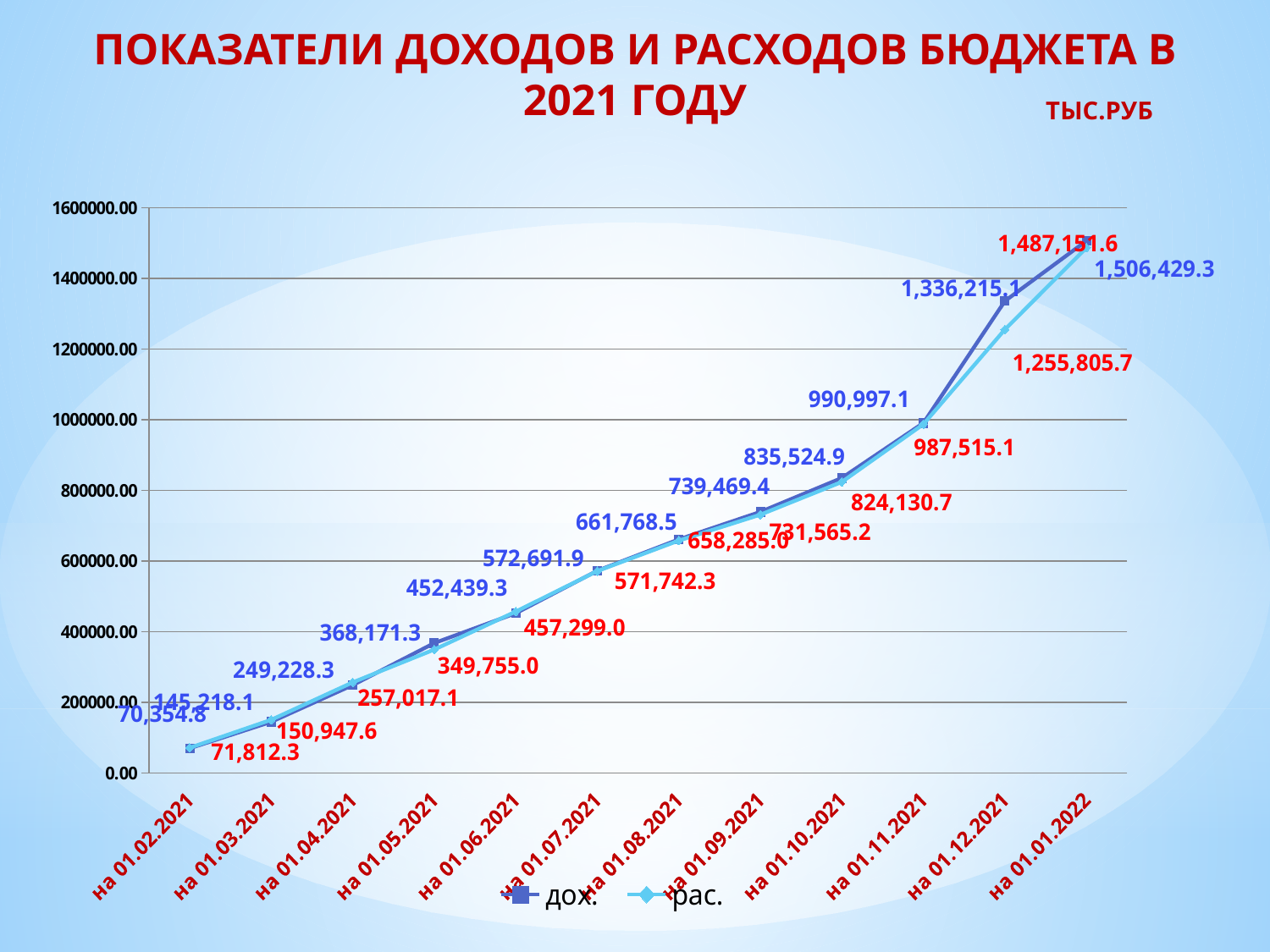
What is the value of дох. на 01.02.2021? 70,354.8 Do the values of дох. rise or fall from 01.02.2021 to 01.01.2022? rise What is the value of рас. на 01.05.2021? 349,755.0 At which date is рас. lowest? на 01.02.2021 What kind of chart is shown on the slide? line chart How many series does the legend list? 2 What is the value of рас. на 01.01.2022? 1,487,151.6 How many dates are plotted along the x axis? 12 Which is larger на 01.12.2021, дох. or рас.? дох. What is the value of дох. на 01.12.2021? 1,336,215.1 At which date is дох. highest? на 01.01.2022 What is the difference between дох. and рас. на 01.12.2021? 80,409.4